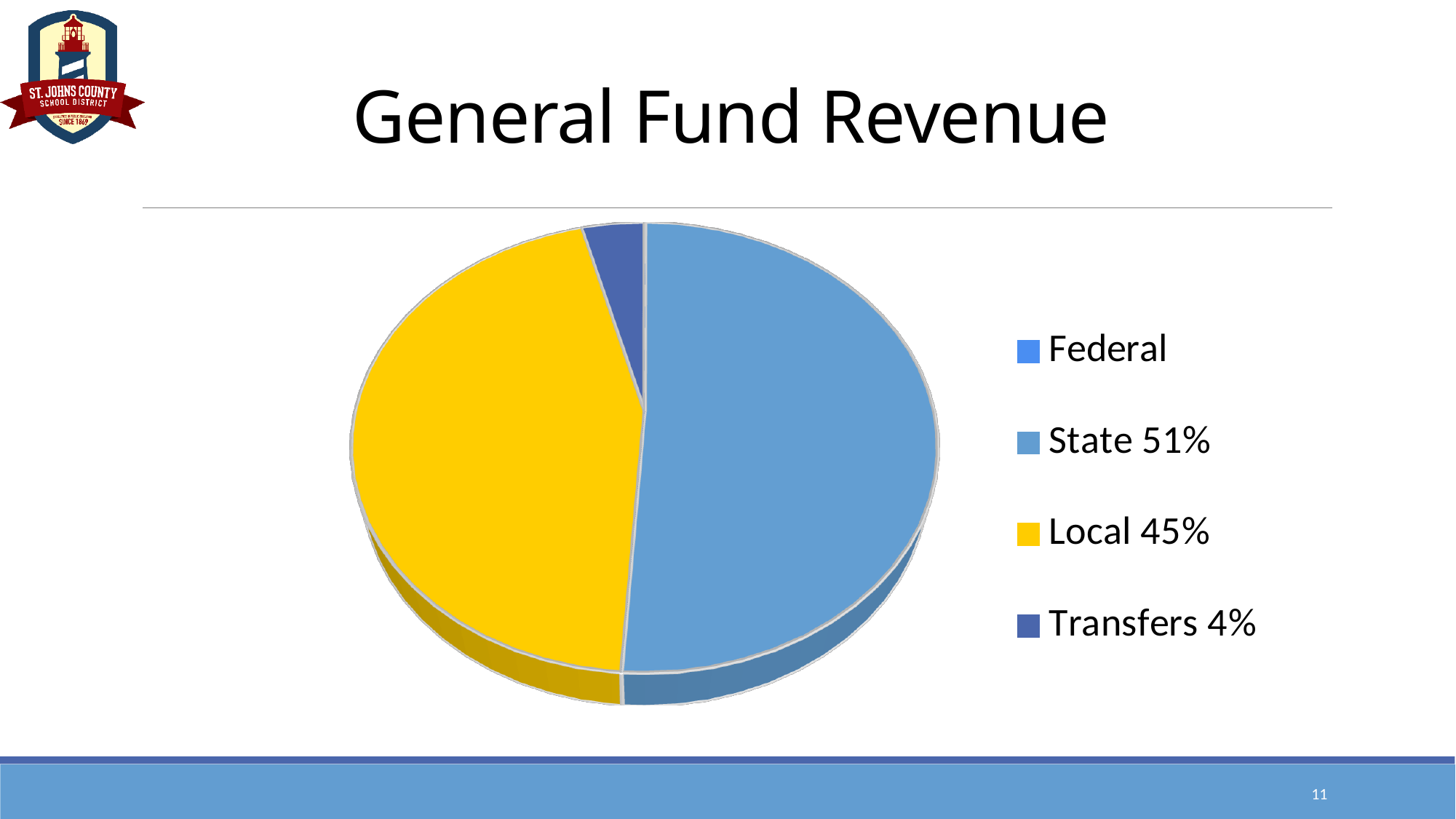
Is the State share greater or less than 50%? greater What is the title of the chart? General Fund Revenue What kind of chart is shown on the slide? pie chart What colour represents Local in the pie chart? yellow What is the difference between the Local share and the Transfers share? 41% How many percentage points larger is the State share than the Local share? 6% What percentage of General Fund Revenue comes from Local? 45% What percentage of General Fund Revenue comes from Transfers? 4% Which revenue source has the largest share of the pie? State What percentage of General Fund Revenue comes from State? 51% How many entries does the legend list? 4 Which is larger, the State share or the Local share? State